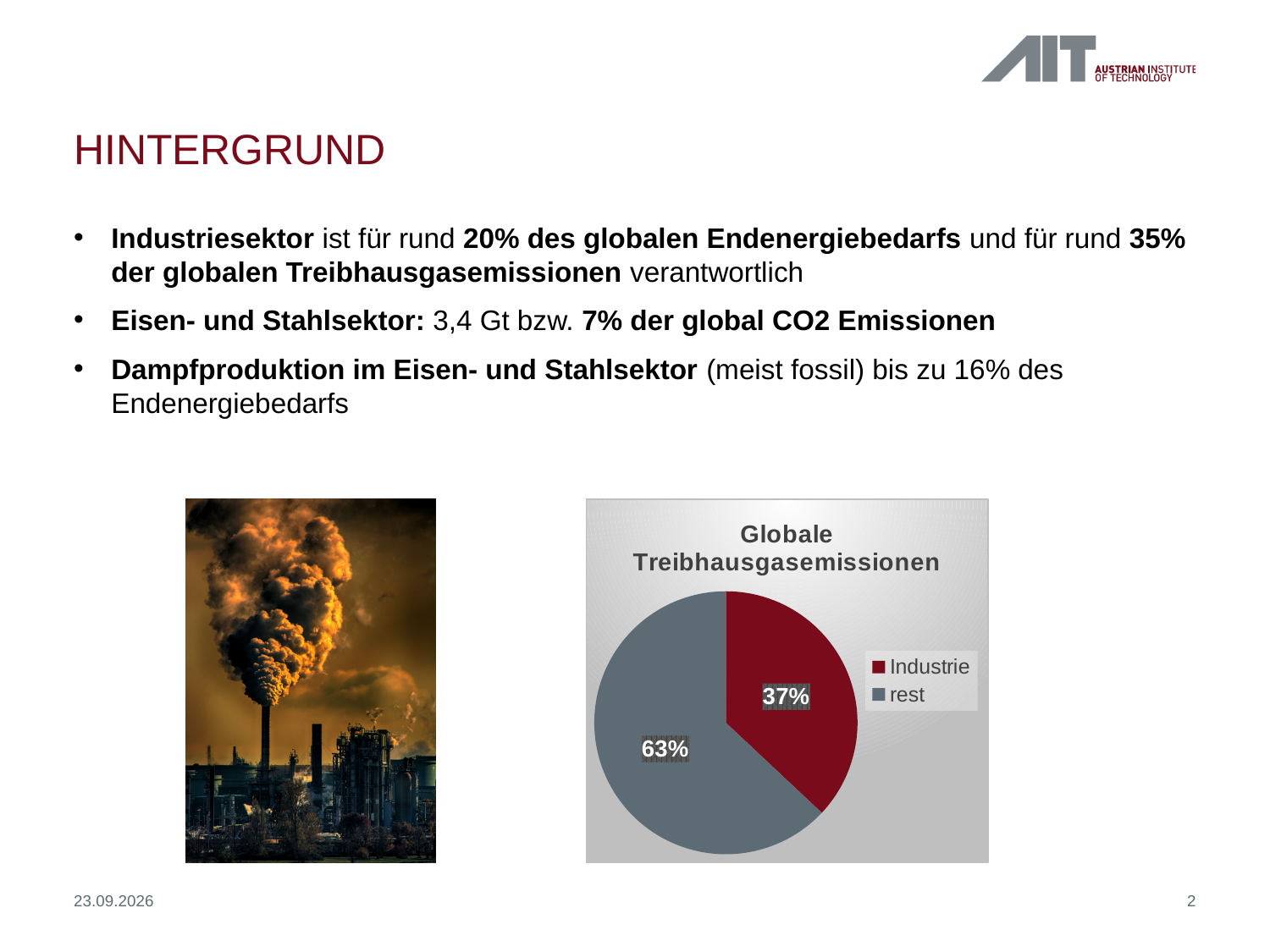
Is the share for Industrie greater or less than 50%? less What is the difference in percentage points between the rest slice and the Industrie slice? 26 percentage points Which slice of the pie is the largest? rest What share of the pie does Industrie account for? 37% What colour is the Industrie slice? dark red What share of the pie does rest account for? 63% How many slices does the pie chart have? 2 How many entries does the legend list? 2 What kind of chart is shown on the slide? pie chart Which is larger, the Industrie slice or the rest slice? rest What is the title of the chart? Globale Treibhausgasemissionen Which slice of the pie is the smallest? Industrie